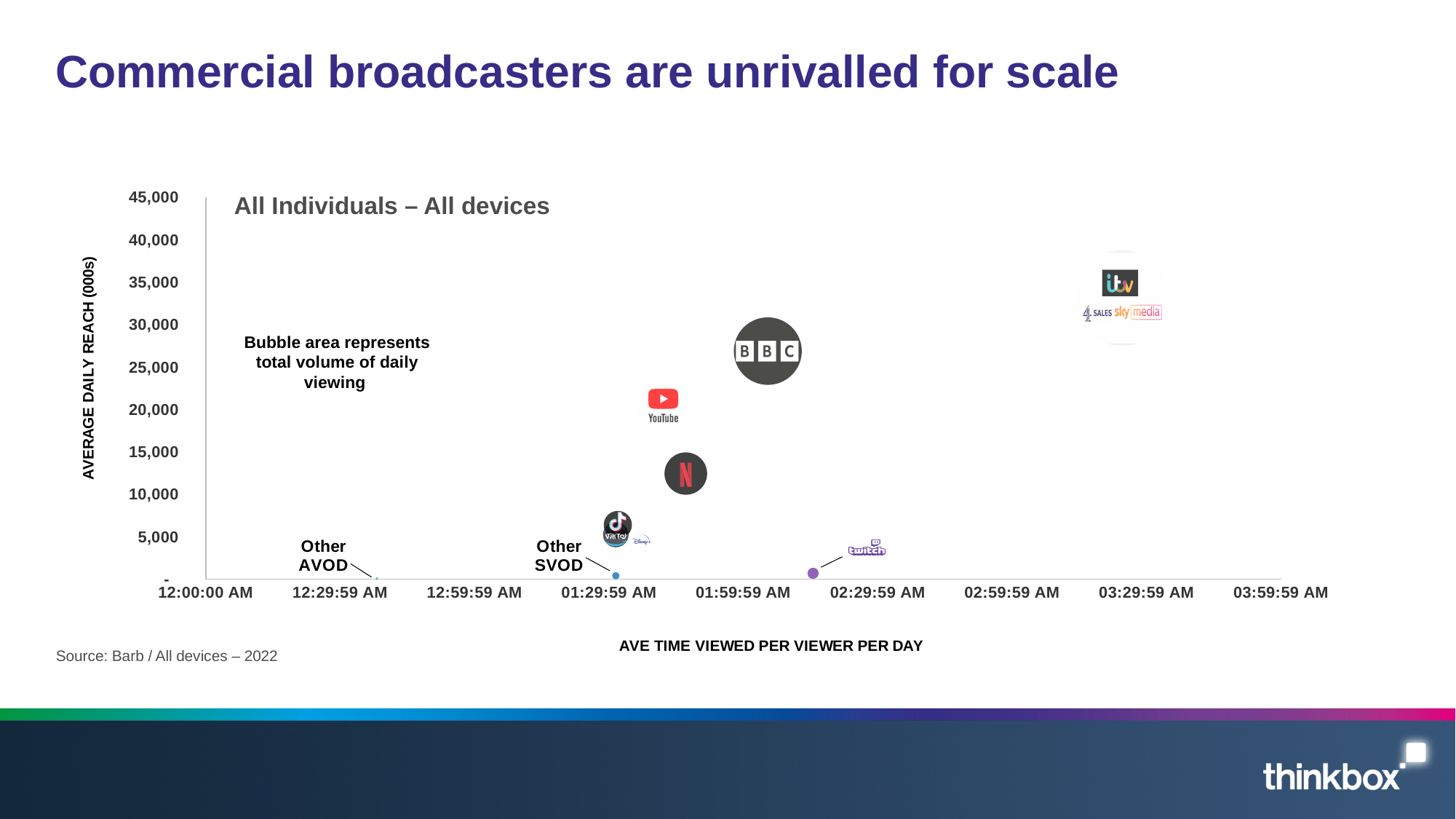
Which bubble has the highest average daily reach? the commercial broadcasters (ITV, 4 Sales, Sky Media) What kind of chart is shown on the slide? bubble chart Is the average daily reach for Netflix greater or less than 10,000? greater What does the y axis of the chart measure? AVERAGE DAILY REACH (000s) Is the average daily reach for Twitch greater or less than 5,000? less Which has the higher average daily reach, BBC or YouTube? BBC What is the title shown inside the chart area? All Individuals – All devices Which has the higher average daily reach, Netflix or TikTok? Netflix Is the average daily reach for Netflix greater or less than 15,000? less Which has the longer average time viewed per viewer per day, BBC or Netflix? BBC